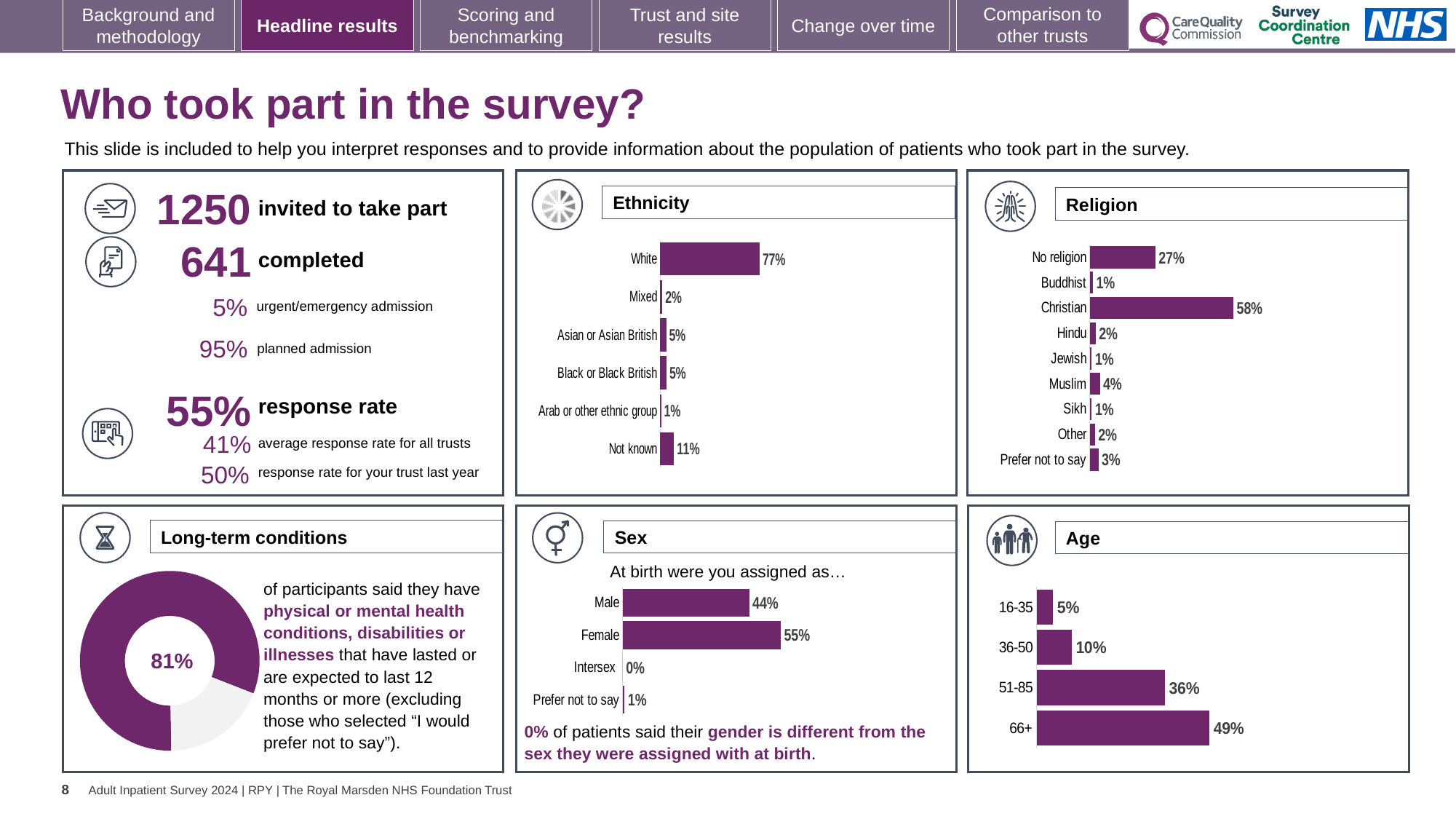
In the Age chart, which age group has the lowest value? 16-35 In the Sex chart, what percentage of participants answered Prefer not to say? 1% In the Religion chart, what is the difference between the values for Christian and No religion? 31% In the Sex chart, which is larger, Male or Female? Female In the Age chart, what is the difference between the values for 66+ and 51-85? 13% In the Religion chart, what percentage of participants were Christian? 58% In the Age chart, do the values rise or fall as you go from 16-35 to 66+? rise In the Ethnicity chart, what percentage of participants were White? 77% What kind of chart is used in the Long-term conditions panel? Doughnut chart In the Ethnicity chart, how many categories are shown? 6 In the Religion chart, how many categories are shown? 9 In the Ethnicity chart, which category has the highest value? White